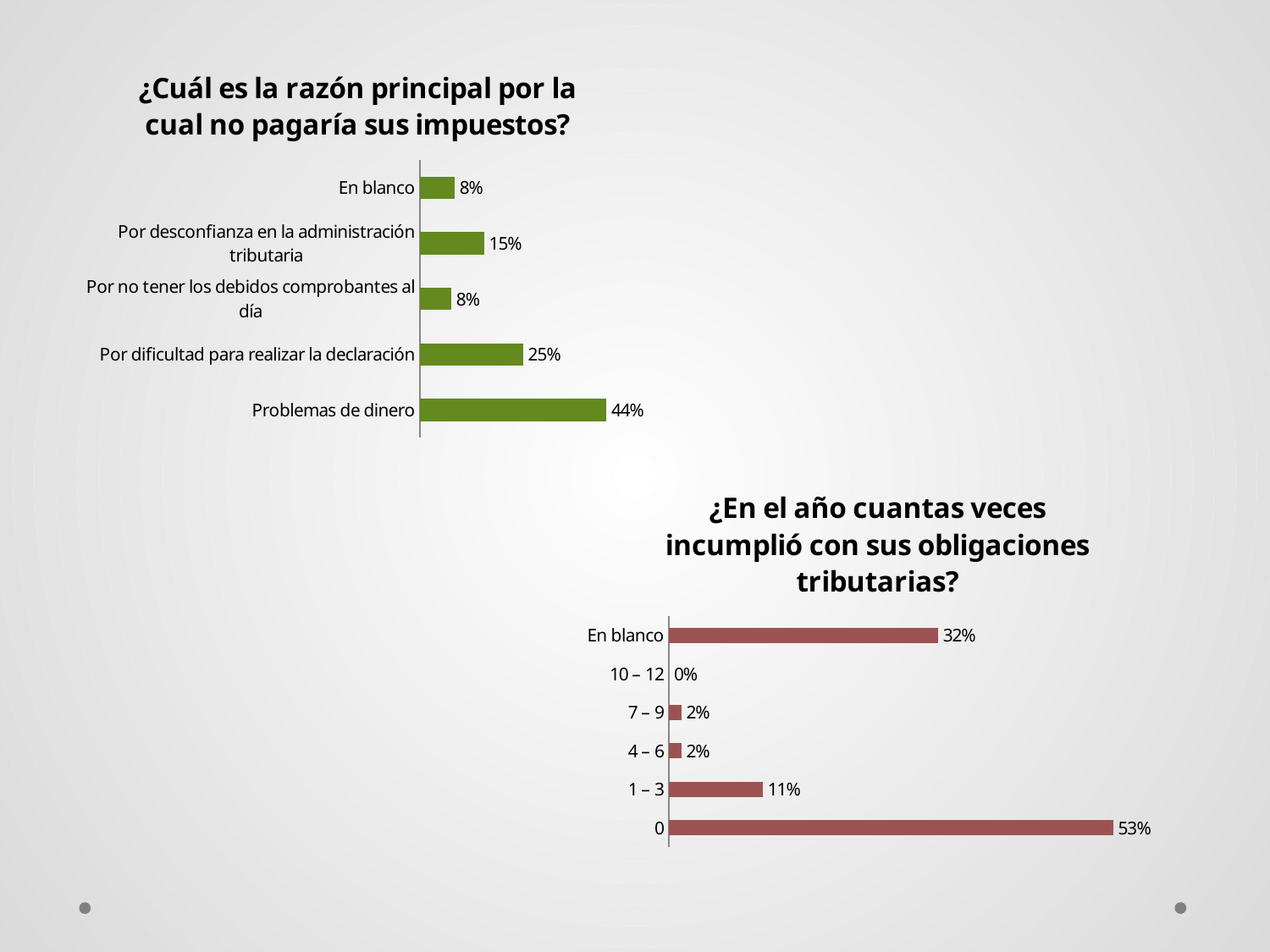
In the chart '¿Cuál es la razón principal por la cual no pagaría sus impuestos?', which is larger: 'Por desconfianza en la administración tributaria' or 'Por no tener los debidos comprobantes al día'? Por desconfianza en la administración tributaria In the chart '¿Cuál es la razón principal por la cual no pagaría sus impuestos?', how many categories are shown? 5 In the chart '¿En el año cuantas veces incumplió con sus obligaciones tributarias?', how many categories are shown? 6 In the chart '¿En el año cuantas veces incumplió con sus obligaciones tributarias?', what is the value for '1 – 3'? 11% In the chart '¿En el año cuantas veces incumplió con sus obligaciones tributarias?', which category has the lowest value? 10 – 12 In the chart '¿En el año cuantas veces incumplió con sus obligaciones tributarias?', what is the value for '0'? 53% In the chart '¿Cuál es la razón principal por la cual no pagaría sus impuestos?', what is the value for 'Por dificultad para realizar la declaración'? 25% In the chart '¿Cuál es la razón principal por la cual no pagaría sus impuestos?', which category has the highest value? Problemas de dinero In the chart '¿Cuál es la razón principal por la cual no pagaría sus impuestos?', what is the difference between 'Problemas de dinero' and 'Por desconfianza en la administración tributaria'? 29% In the chart '¿En el año cuantas veces incumplió con sus obligaciones tributarias?', what is the difference between '0' and 'En blanco'? 21% What type of chart is '¿En el año cuantas veces incumplió con sus obligaciones tributarias?'? Bar chart In the chart '¿Cuál es la razón principal por la cual no pagaría sus impuestos?', what is the value for 'Problemas de dinero'? 44%